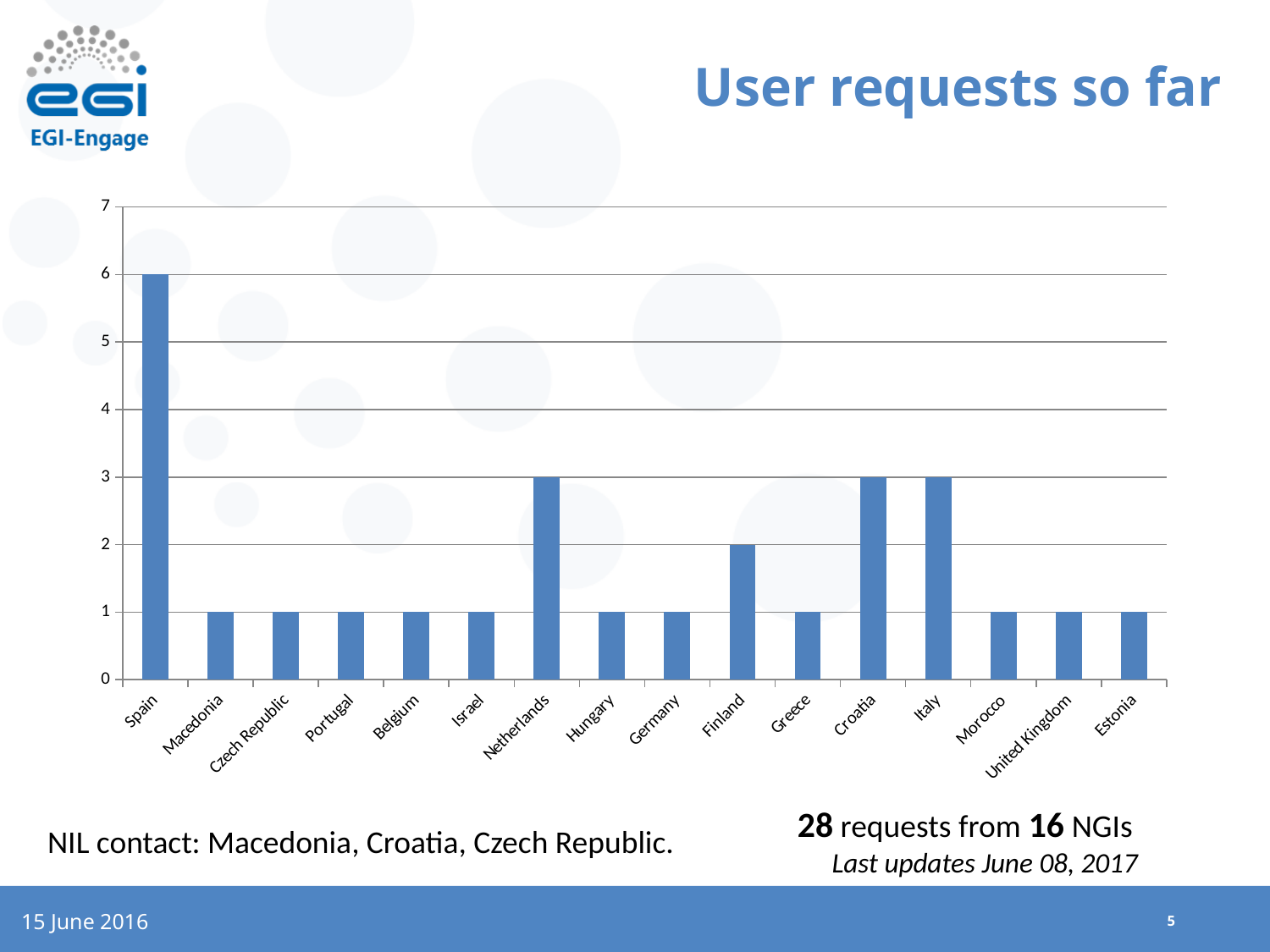
What kind of chart is shown on the slide? bar chart What is the value for Finland? 2 How many categories are shown on the x axis? 16 Is the value for Spain greater or less than 5? greater What is the value for Spain? 6 What is the value for Netherlands? 3 Which category has the highest value? Spain What is the title of the slide containing the chart? User requests so far What is the difference between the values for Spain and Italy? 3 What is the value for Hungary? 1 What is the highest value shown on the y axis? 7 Which is larger, the value for Croatia or the value for Finland? Croatia